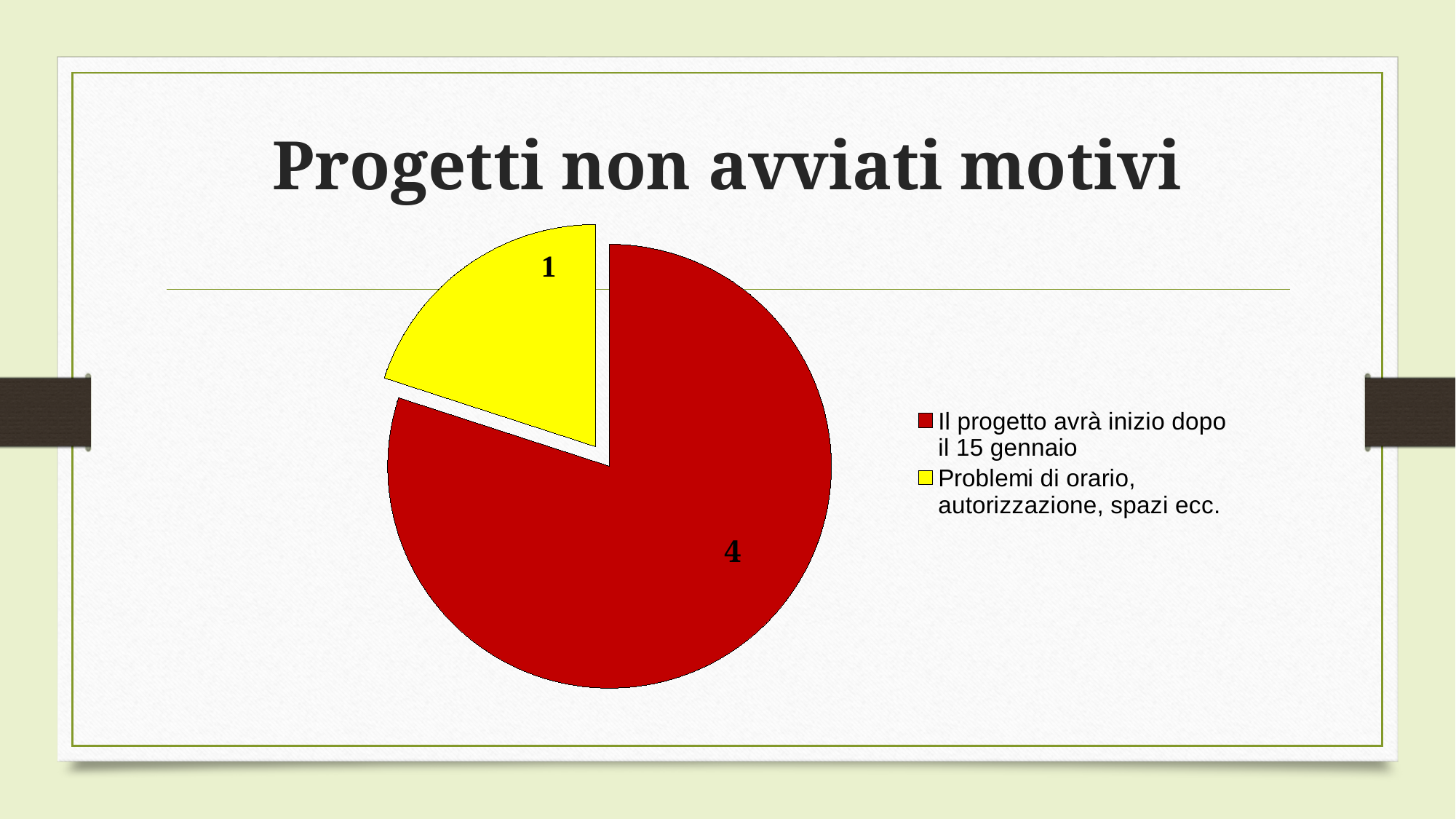
Which category has the largest slice? Il progetto avrà inizio dopo il 15 gennaio What kind of chart is shown on the slide? pie chart What share of the pie does "Problemi di orario, autorizzazione, spazi ecc." represent? 20% Which category has the smallest slice? Problemi di orario, autorizzazione, spazi ecc. What is the difference between the value for "Il progetto avrà inizio dopo il 15 gennaio" and the value for "Problemi di orario, autorizzazione, spazi ecc."? 3 What is the value for "Il progetto avrà inizio dopo il 15 gennaio"? 4 Which is larger: the value for "Il progetto avrà inizio dopo il 15 gennaio" or the value for "Problemi di orario, autorizzazione, spazi ecc."? Il progetto avrà inizio dopo il 15 gennaio What is the title of the chart on the slide? Progetti non avviati motivi How many entries does the legend list? 2 What colour is the slice for "Problemi di orario, autorizzazione, spazi ecc."? yellow What is the value for "Problemi di orario, autorizzazione, spazi ecc."? 1 How many slices does the pie chart have? 2